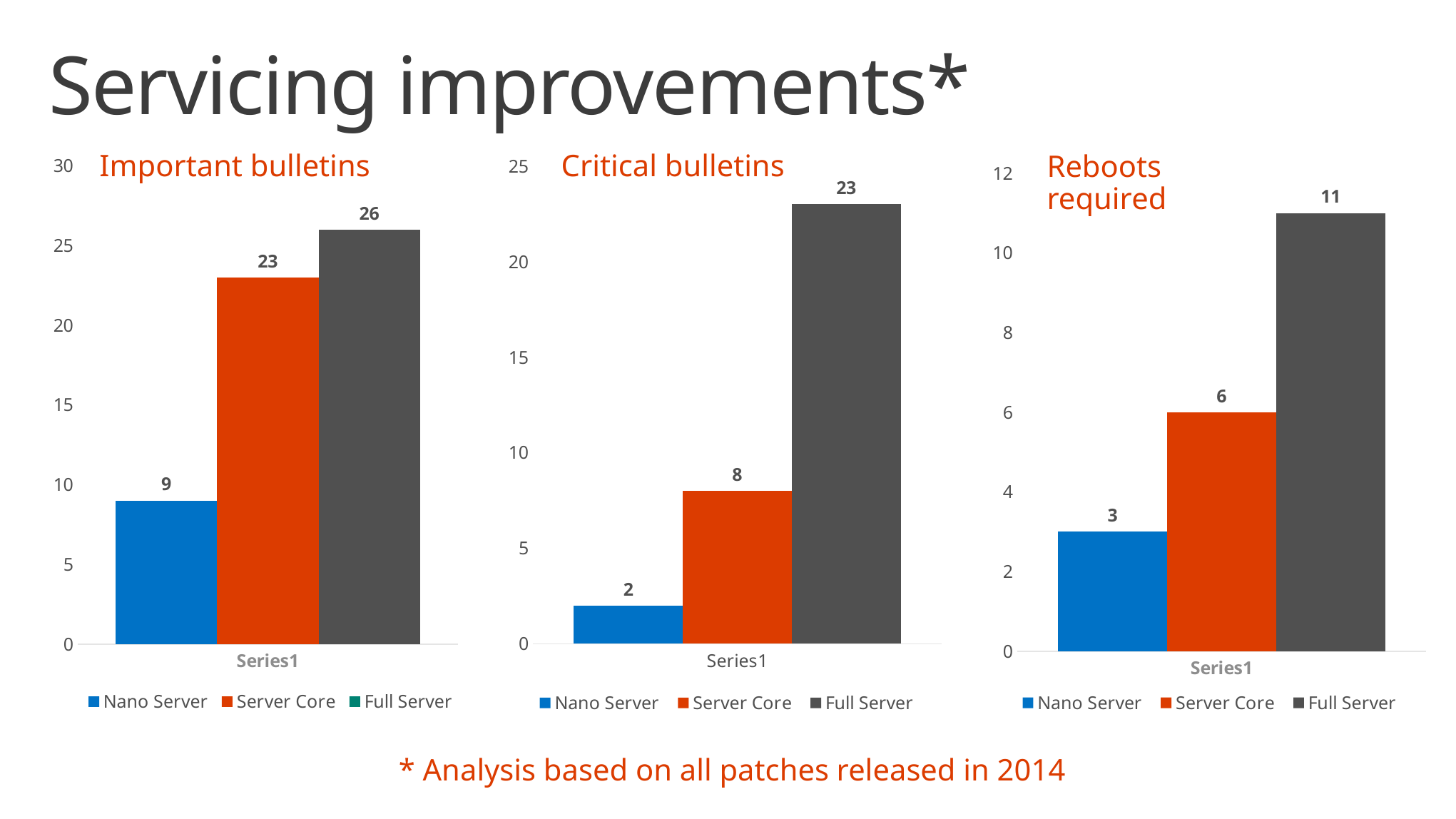
What is the category label shown on the x axis of the Important bulletins chart? Series1 In the Important bulletins chart, which series has the lowest value? Nano Server How many series does the legend of the Critical bulletins chart list? 3 In the Critical bulletins chart, which series has the highest value? Full Server What kind of chart is the Reboots required chart? bar chart In the Critical bulletins chart, what is the value for Full Server? 23 In the Important bulletins chart, what is the difference between Full Server and Nano Server? 17 In the Reboots required chart, what is the difference between Full Server and Server Core? 5 In the Reboots required chart, which is larger, Server Core or Full Server? Full Server In the Important bulletins chart, what is the value for Server Core? 23 In the Critical bulletins chart, is the value for Server Core greater or less than 10? less In the Reboots required chart, what is the value for Nano Server? 3